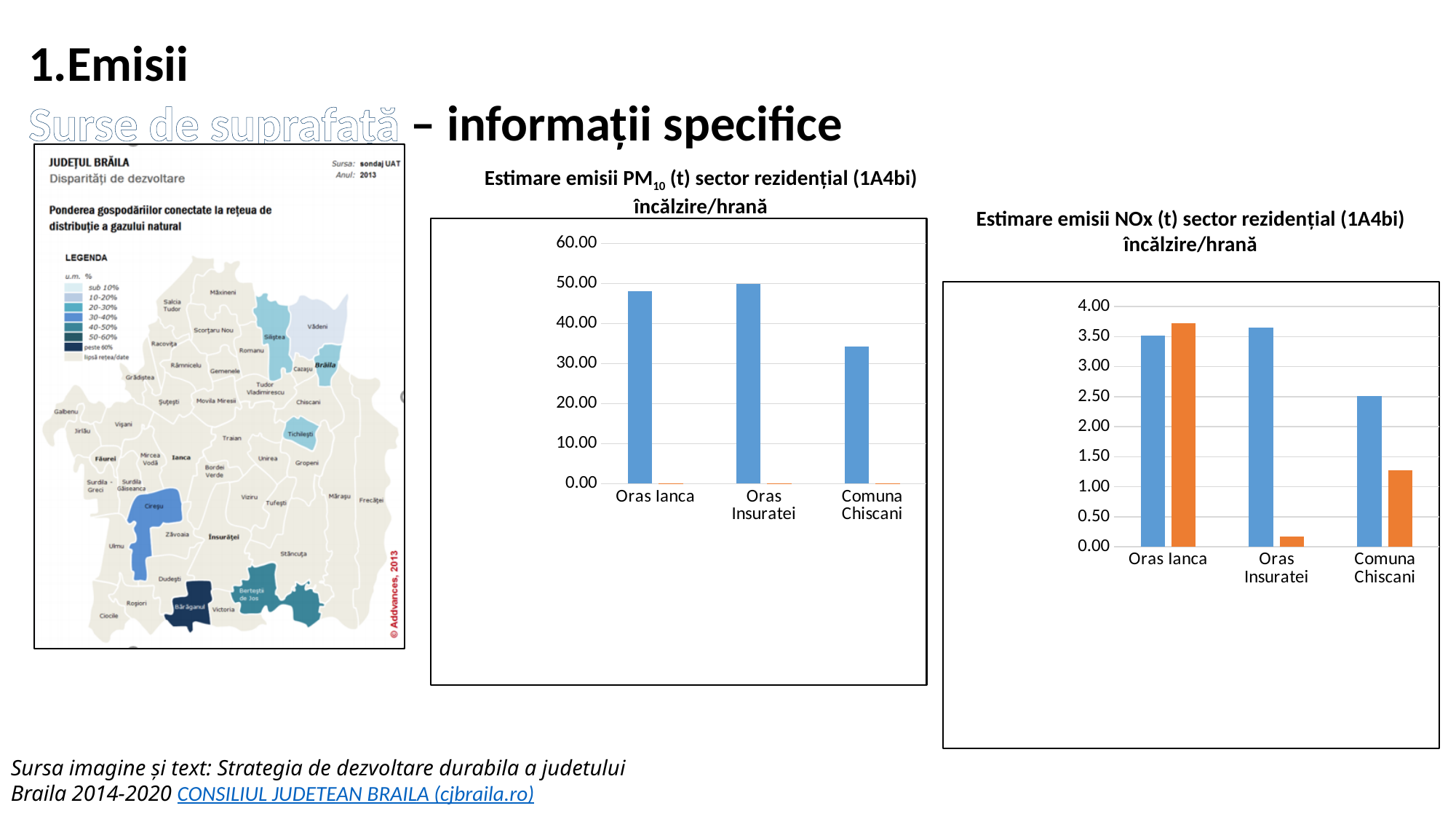
In the NOx chart, is the orange bar for Comuna Chiscani greater or less than 1.00? greater In the NOx chart, which category has the highest orange bar? Oras Ianca In the NOx chart, is the blue bar for Comuna Chiscani greater or less than 3.00? less In the PM10 chart, is the blue bar for Oras Ianca greater or less than 40.00? greater In the NOx chart, which category has the lowest orange bar? Oras Insuratei In the PM10 chart, which category has the lowest blue bar? Comuna Chiscani How many categories are shown on the x axis of the 'Estimare emisii NOx (t) sector rezidențial (1A4bi) încălzire/hrană' chart? 3 In the NOx chart, for Oras Insuratei, which bar is larger, the blue one or the orange one? the blue one What kind of chart is the 'Estimare emisii PM10 (t) sector rezidențial (1A4bi) încălzire/hrană' chart? bar chart In the NOx chart, which category has the lowest blue bar? Comuna Chiscani